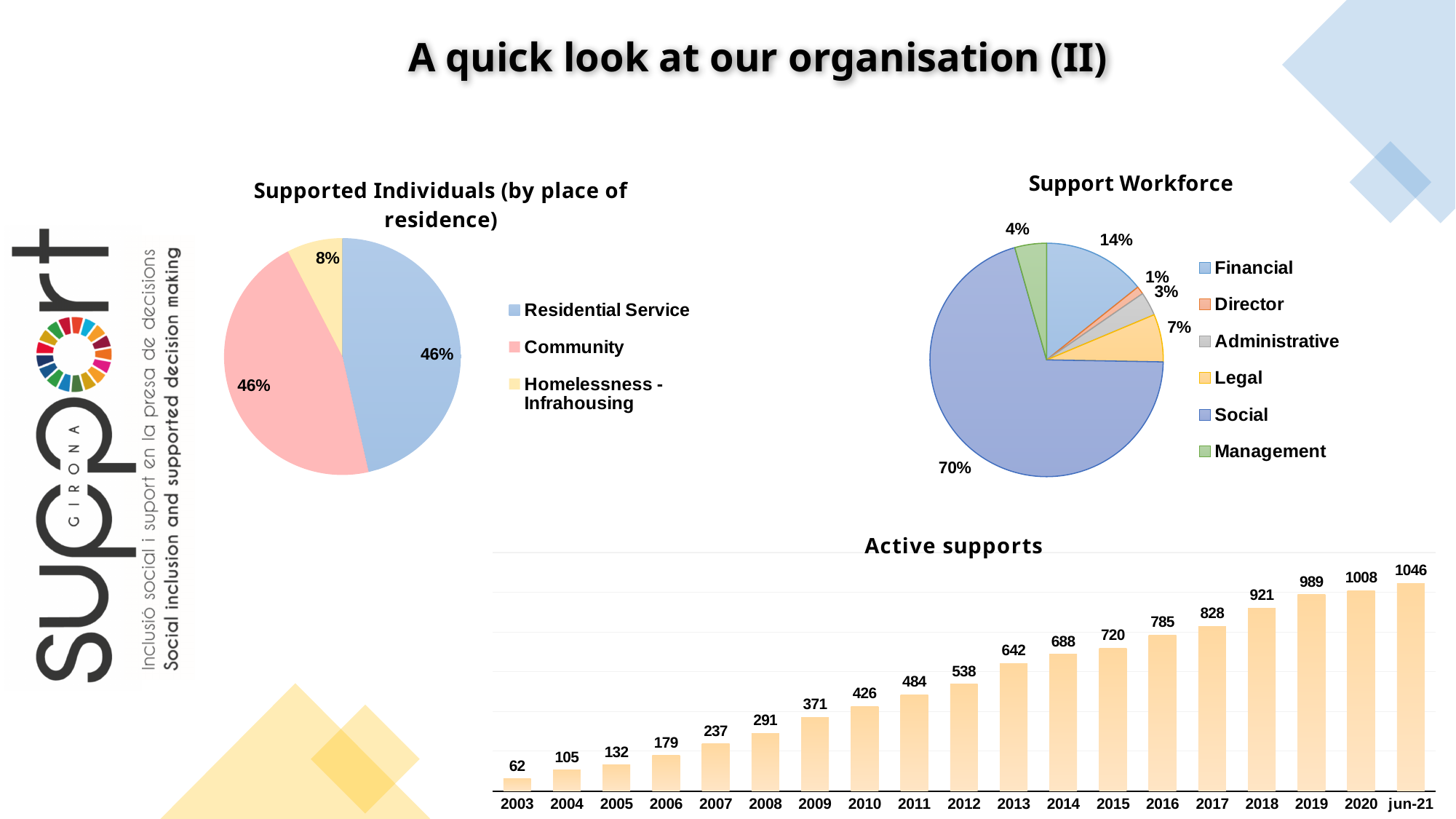
In the 'Supported Individuals (by place of residence)' chart, what share is Community? 46% In the 'Support Workforce' chart, what share is Social? 70% In the 'Support Workforce' chart, what is the difference between the Financial and Legal shares? 7% In the 'Active supports' chart, what is the value for 2015? 720 What kind of chart is the 'Active supports' chart? Bar chart How many categories does the legend of the 'Support Workforce' chart list? 6 In the 'Active supports' chart, do the values rise or fall from 2003 to jun-21? Rise In the 'Supported Individuals (by place of residence)' chart, what share is Homelessness - Infrahousing? 8% How many bars are shown in the 'Active supports' chart? 19 In the 'Support Workforce' chart, which category has the smallest share? Director How many categories does the legend of the 'Supported Individuals (by place of residence)' chart list? 3 In the 'Active supports' chart, what is the difference between the values for 2020 and 2003? 946